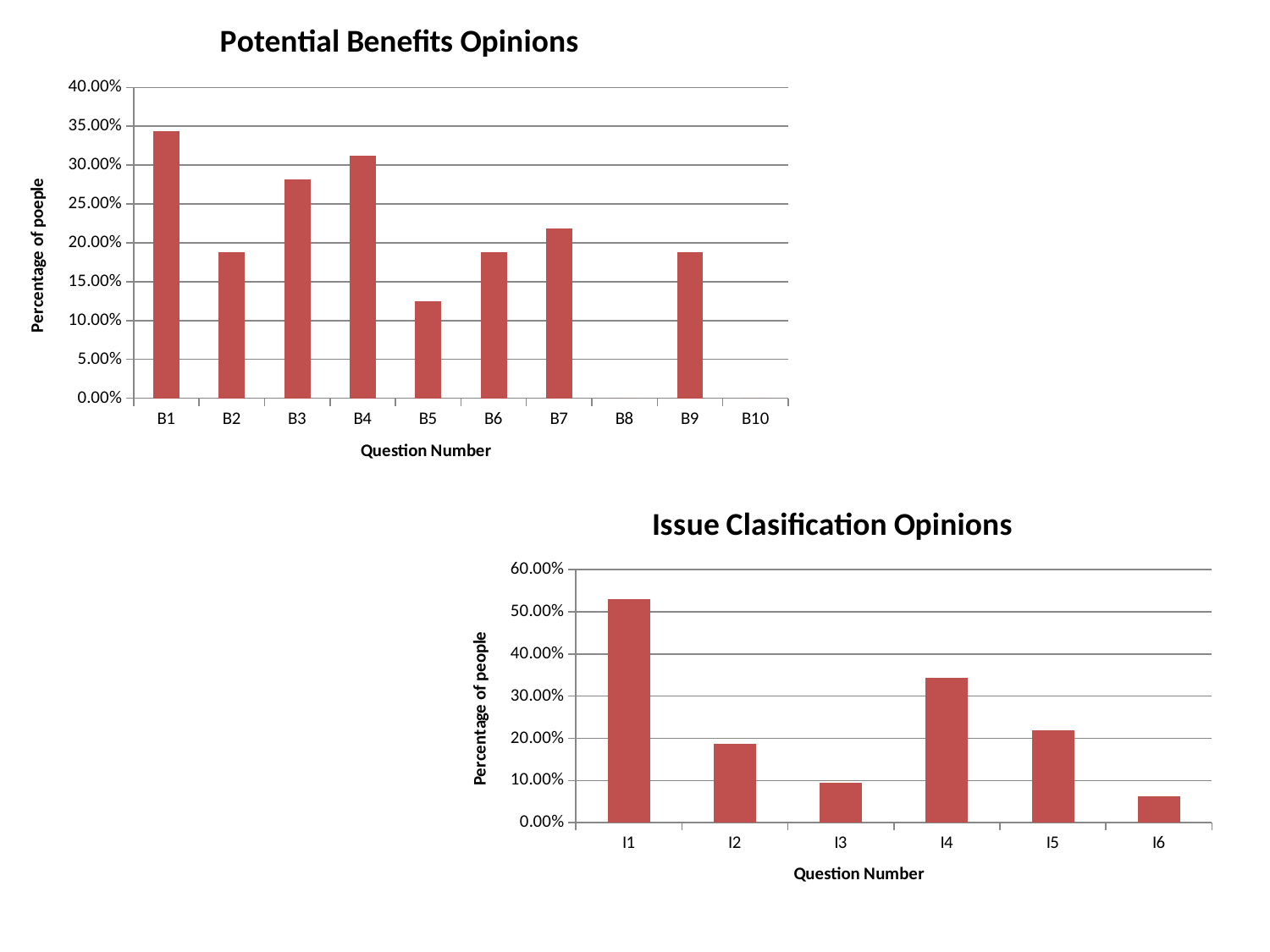
In the "Potential Benefits Opinions" chart, is the value for B1 greater or less than 30.00%? greater In the "Issue Clasification Opinions" chart, which question number has the highest percentage? I1 In the "Potential Benefits Opinions" chart, is the value for B5 greater or less than 15.00%? less In the "Issue Clasification Opinions" chart, which is larger, the value for I4 or the value for I5? I4 How many question categories are shown on the x axis of the "Issue Clasification Opinions" chart? 6 In the "Issue Clasification Opinions" chart, which question number has the lowest percentage? I6 What is the y-axis label of the "Potential Benefits Opinions" chart? Percentage of poeple How many question categories are shown on the x axis of the "Potential Benefits Opinions" chart? 10 In the "Potential Benefits Opinions" chart, which is larger, the value for B3 or the value for B7? B3 In the "Potential Benefits Opinions" chart, which question number has the highest percentage? B1 What kind of chart is the "Potential Benefits Opinions" chart? bar chart In the "Issue Clasification Opinions" chart, is the value for I1 greater or less than 50.00%? greater